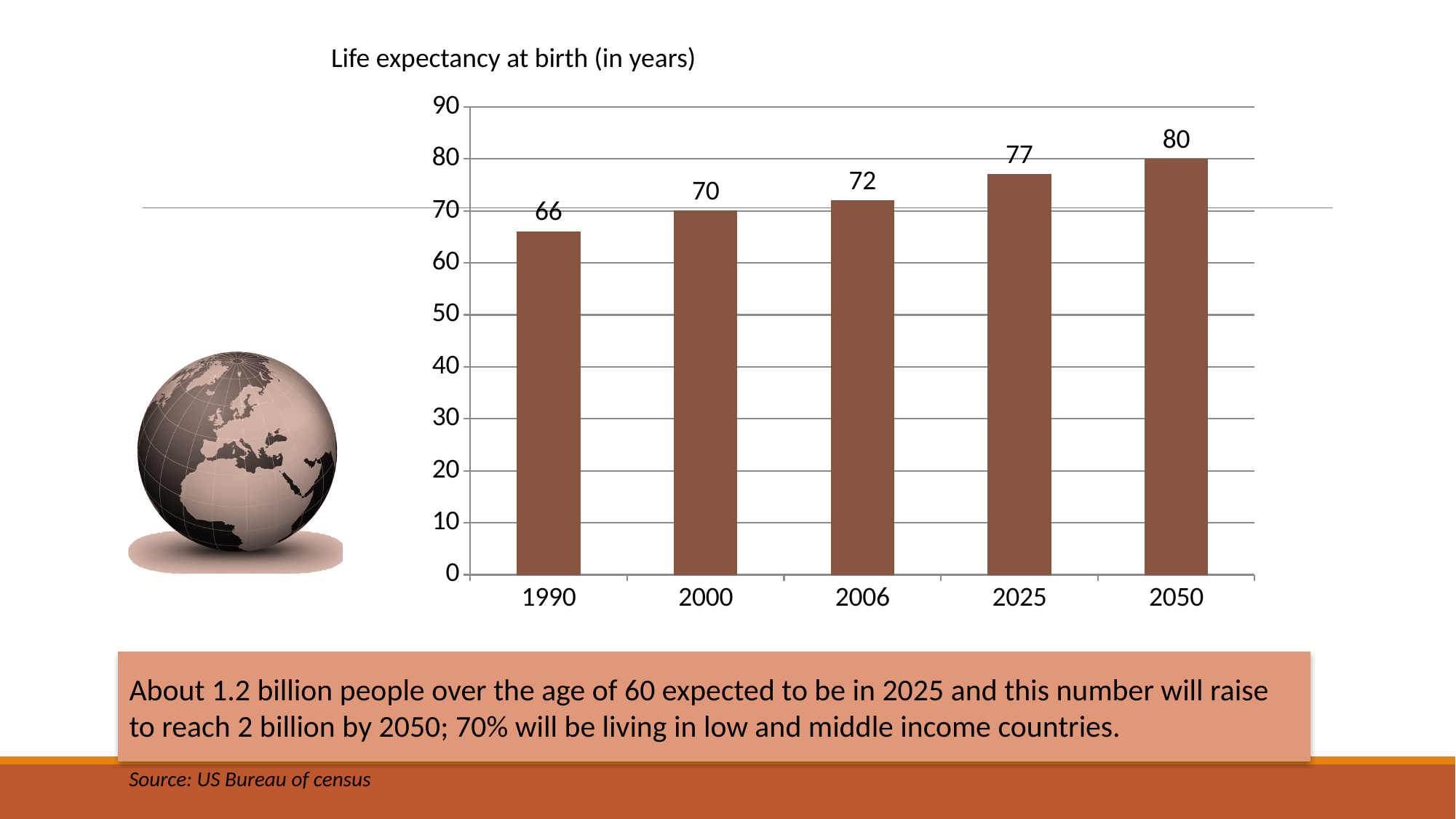
What is the difference between the life expectancy values for 2050 and 1990? 14 What is the difference between the values for 2025 and 2000? 7 Which year has the highest life expectancy at birth? 2050 What is the life expectancy at birth shown for 2050? 80 Do the values rise or fall from 1990 to 2050? Rise Which is larger, the value for 2000 or the value for 2006? 2006 What is the life expectancy at birth shown for 1990? 66 What value is shown for 2006? 72 How many years are shown on the x axis of the chart? 5 Which year has the lowest life expectancy at birth? 1990 What kind of chart is shown on the slide? Bar chart Is the value for 2025 greater or less than 70? greater